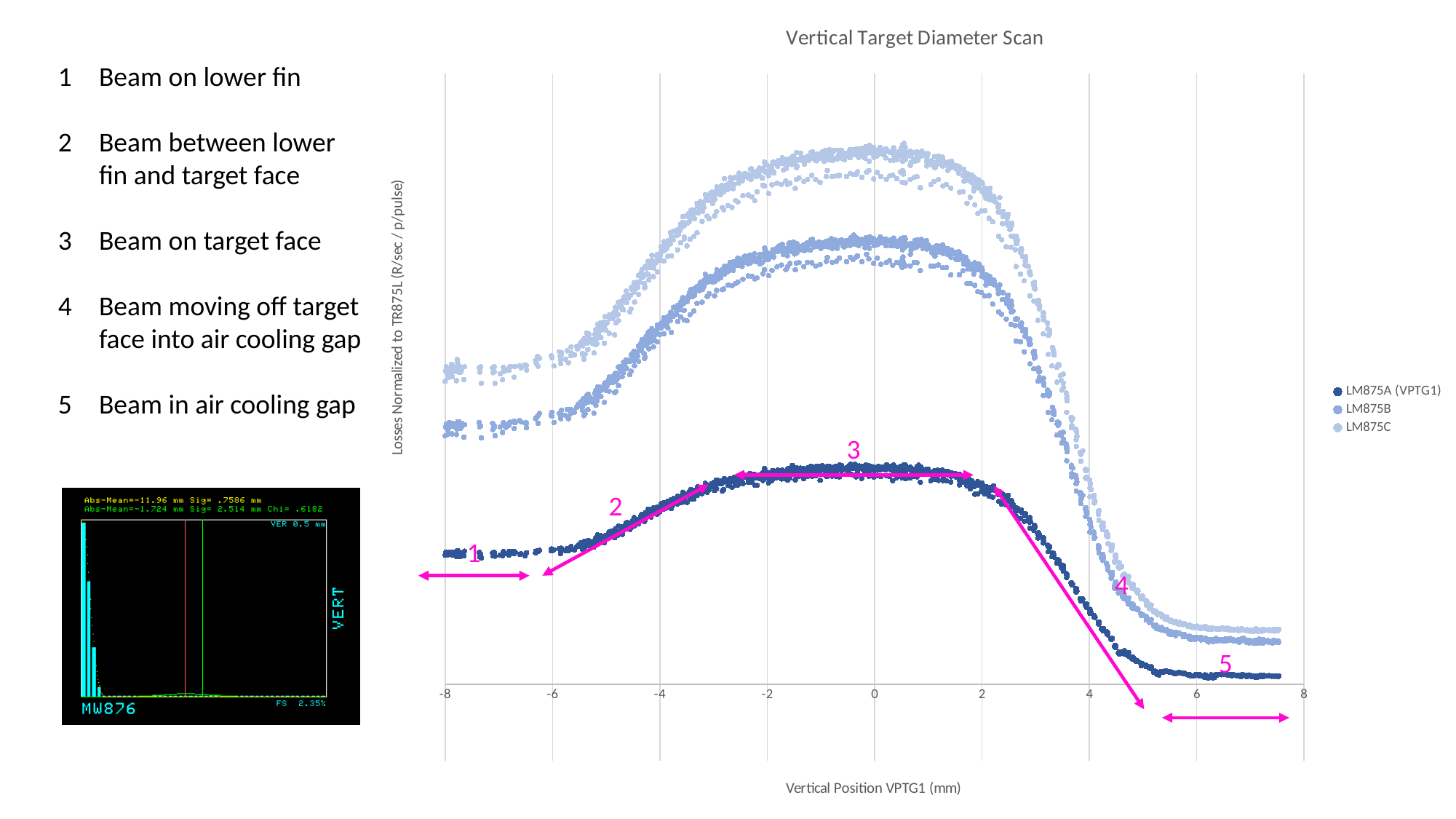
Which series has the lowest values at a vertical position of 0 mm? LM875A (VPTG1) What is the highest value shown on the x axis of the chart? 8 How many series does the legend of the chart list? 3 Do the values of the LM875A (VPTG1) series rise or fall as the vertical position goes from -8 mm to 0 mm? rise What is the title of the chart? Vertical Target Diameter Scan At a vertical position of -8 mm, which series has larger values, LM875B or LM875C? LM875C For the LM875B series, is the value larger at a vertical position of 0 mm or at 6 mm? 0 mm What is the lowest value shown on the x axis of the chart? -8 Which series has the highest values at a vertical position of 0 mm? LM875C What is the label of the x axis of the chart? Vertical Position VPTG1 (mm) Do the values of the LM875C series rise or fall as the vertical position goes from 2 mm to 6 mm? fall What kind of chart is shown on the slide? scatter chart